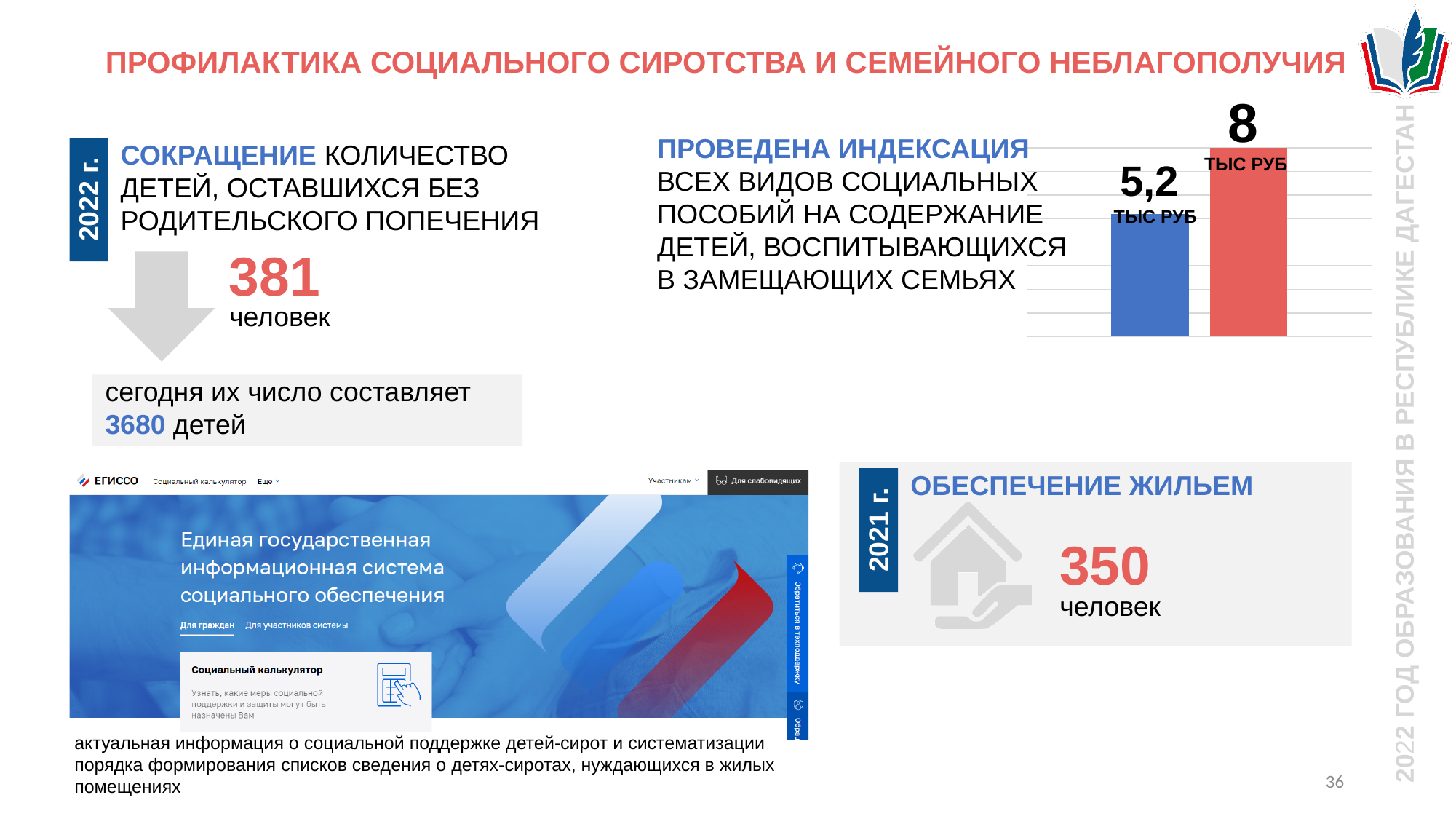
Do the bar values in the chart rise or fall from left to right? rise What value is printed above the red bar in the chart? 8 ТЫС РУБ What value is printed above the blue bar in the chart? 5,2 ТЫС РУБ What is the difference between the red bar (8) and the blue bar (5,2) in the chart, in thousand rubles? 2,8 Which bar in the chart is the tallest? the red bar (8 ТЫС РУБ) What unit is shown under the values in the chart? ТЫС РУБ What colour is the left bar in the chart? blue Which is larger in the chart: the blue bar or the red bar? the red bar How many bars does the chart on the slide have? 2 What type of chart is shown on the slide next to the text about indexation of social benefits? bar chart Which bar in the chart is the shortest? the blue bar (5,2 ТЫС РУБ)